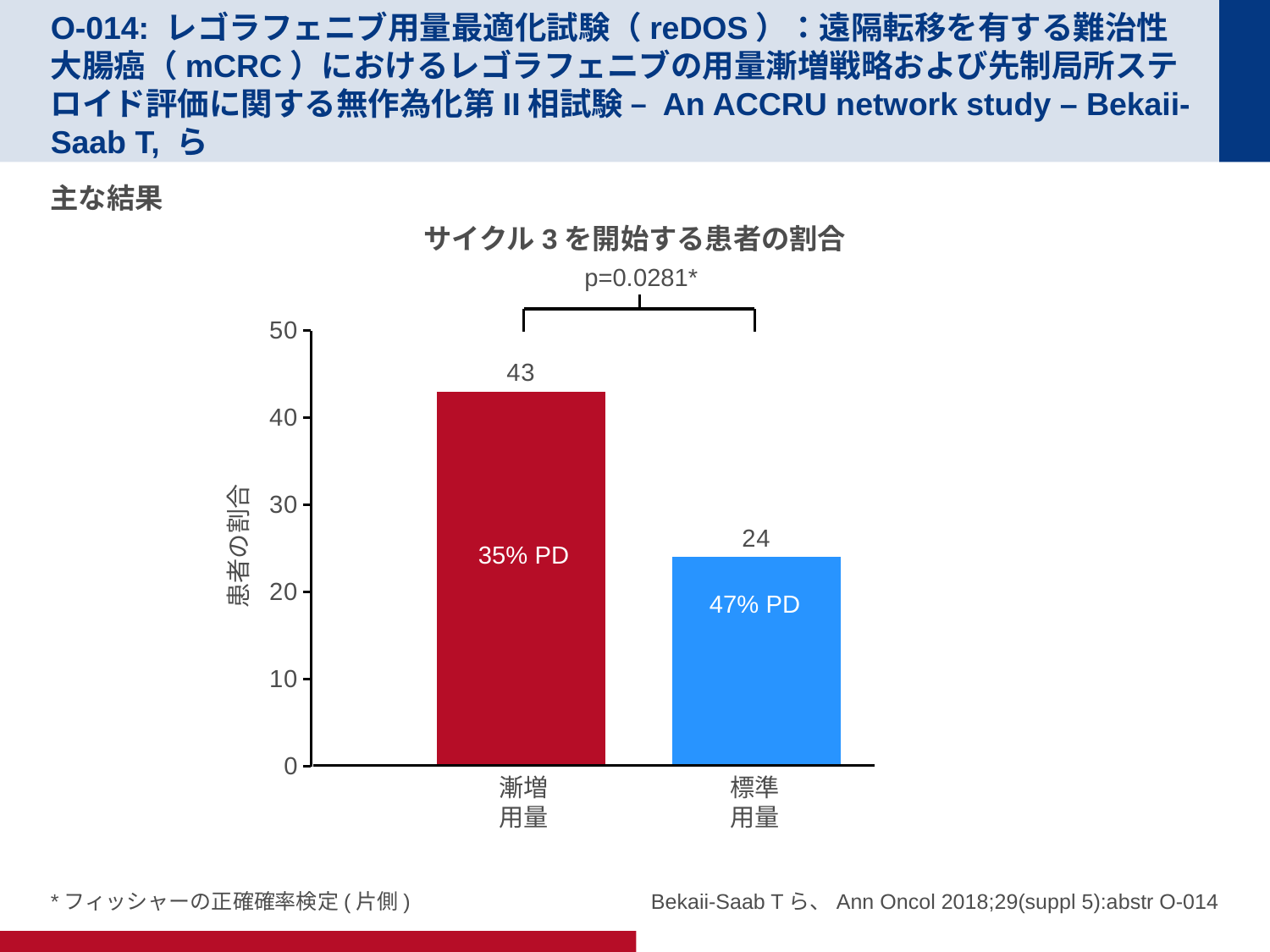
What PD percentage is printed inside the 漸増用量 bar? 35% PD Which category has the highest value? 漸増用量 Is the value for 標準用量 greater or less than 30? less What is the difference between the values for 漸増用量 and 標準用量? 19 What is the value for 漸増用量 (dose escalation) in the chart? 43 How many categories are shown on the x axis? 2 What kind of chart is shown on the slide? bar chart Which category has the lowest value? 標準用量 What is the value for 標準用量 (standard dose) in the chart? 24 What p-value is shown above the bars? p=0.0281* What PD percentage is printed inside the 標準用量 bar? 47% PD Which is larger, the value for 漸増用量 or for 標準用量? 漸増用量